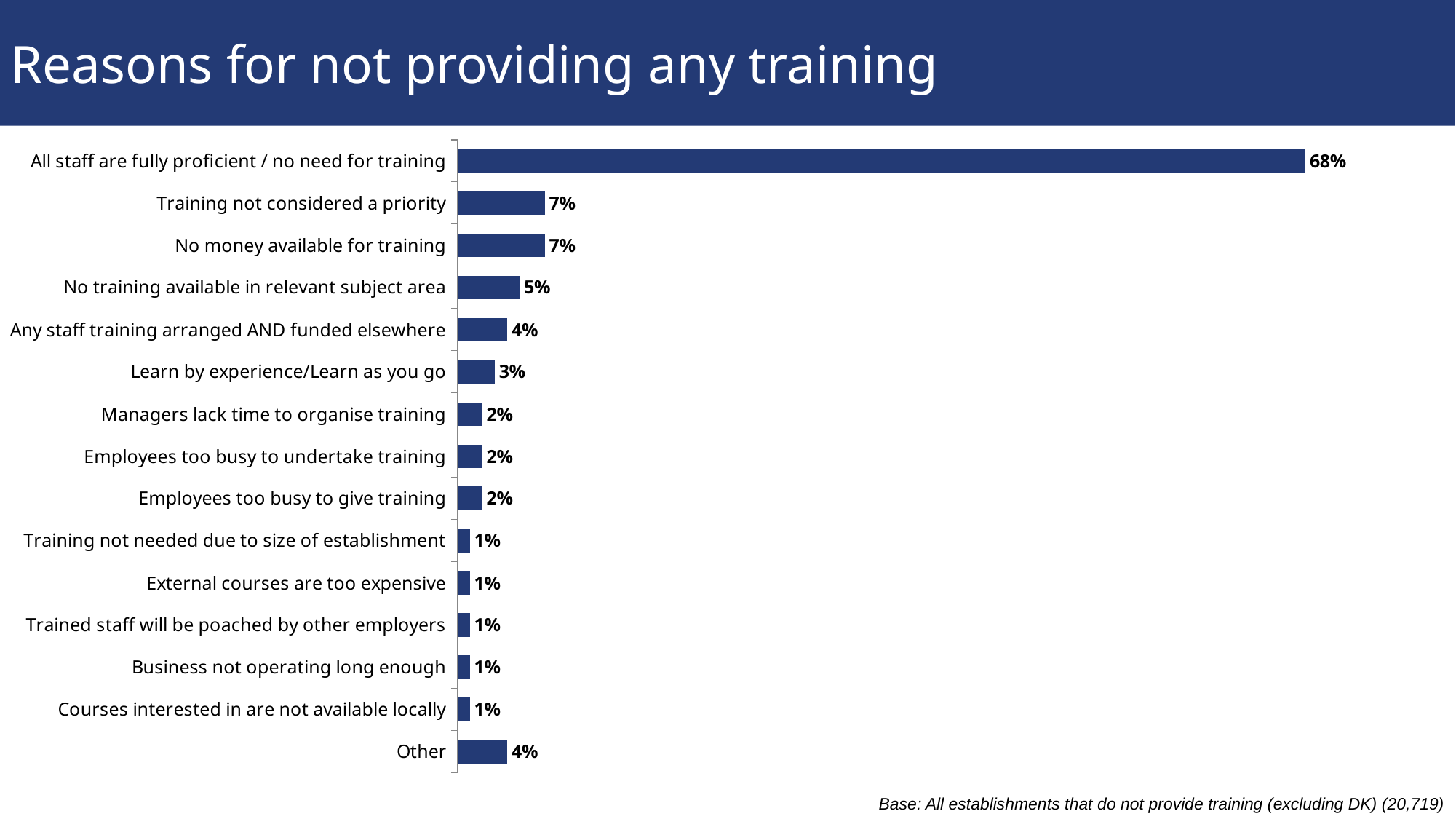
What is the value for 'No training available in relevant subject area'? 5% What is the value for 'Learn by experience/Learn as you go'? 3% Which is larger: 'Other' or 'Learn by experience/Learn as you go'? Other What is the value for 'Other'? 4% What is the difference between 'All staff are fully proficient / no need for training' and 'Training not considered a priority'? 61% What is the title of the slide? Reasons for not providing any training What is the difference between 'No money available for training' and 'Any staff training arranged AND funded elsewhere'? 3% What percentage of establishments gave 'All staff are fully proficient / no need for training' as a reason? 68% How many reasons (categories) are shown in the chart? 15 What kind of chart is shown on the slide? Bar chart Which reason has the highest percentage? All staff are fully proficient / no need for training Which is larger: 'No training available in relevant subject area' or 'Managers lack time to organise training'? No training available in relevant subject area